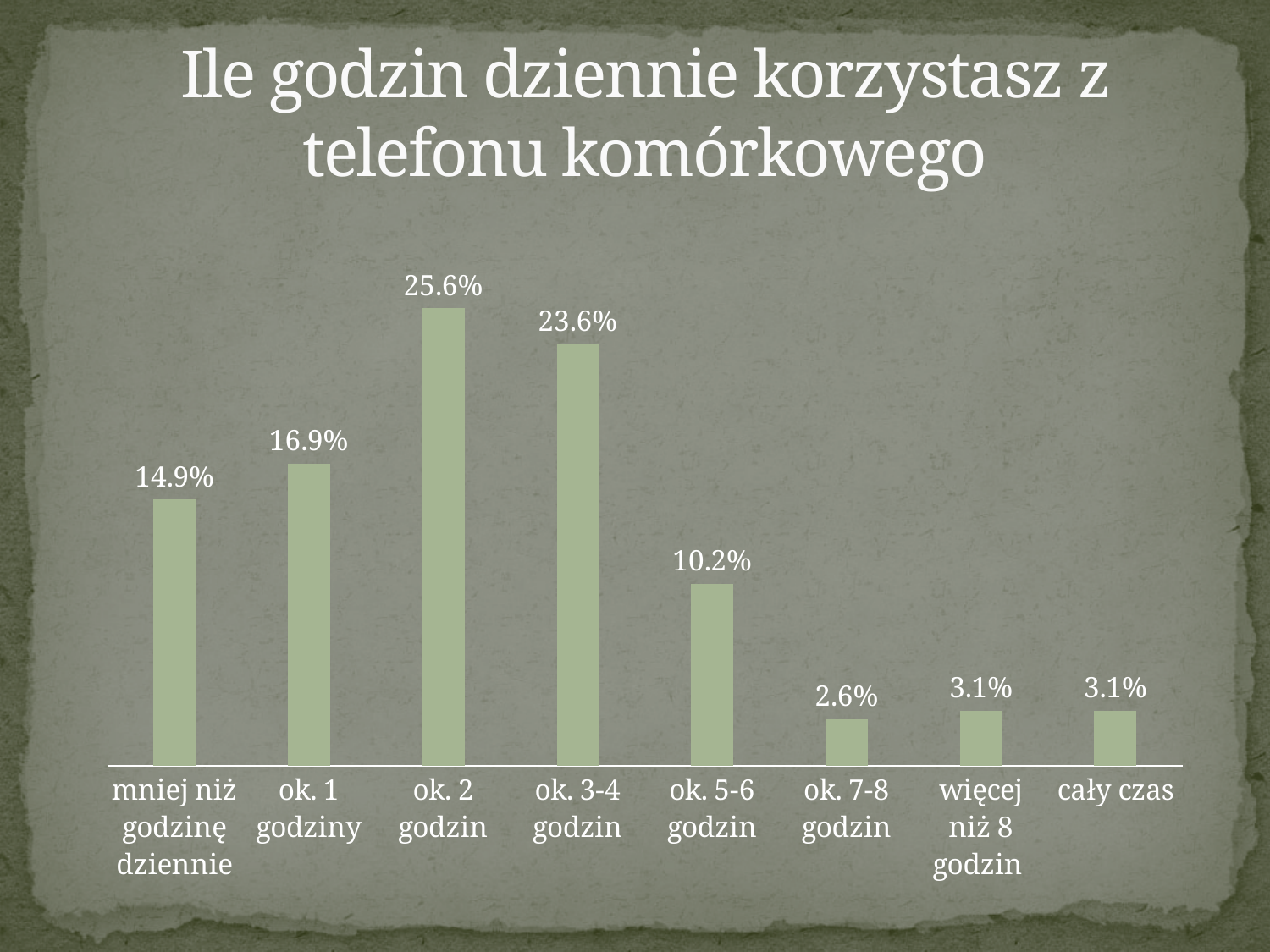
What is the value for "mniej niż godzinę dziennie"? 14.9% What is the value for "ok. 2 godzin"? 25.6% What is the value for "ok. 7-8 godzin"? 2.6% What is the title of the chart? Ile godzin dziennie korzystasz z telefonu komórkowego Which category has the lowest value? ok. 7-8 godzin Which is larger, the value for "ok. 1 godziny" or the value for "ok. 5-6 godzin"? ok. 1 godziny How many categories are shown on the x axis? 8 What kind of chart is shown on the slide? bar chart What is the difference between the values for "ok. 2 godzin" and "ok. 3-4 godzin"? 2.0% Which category has the highest value? ok. 2 godzin What is the value for "ok. 5-6 godzin"? 10.2% What is the difference between the values for "ok. 1 godziny" and "mniej niż godzinę dziennie"? 2.0%